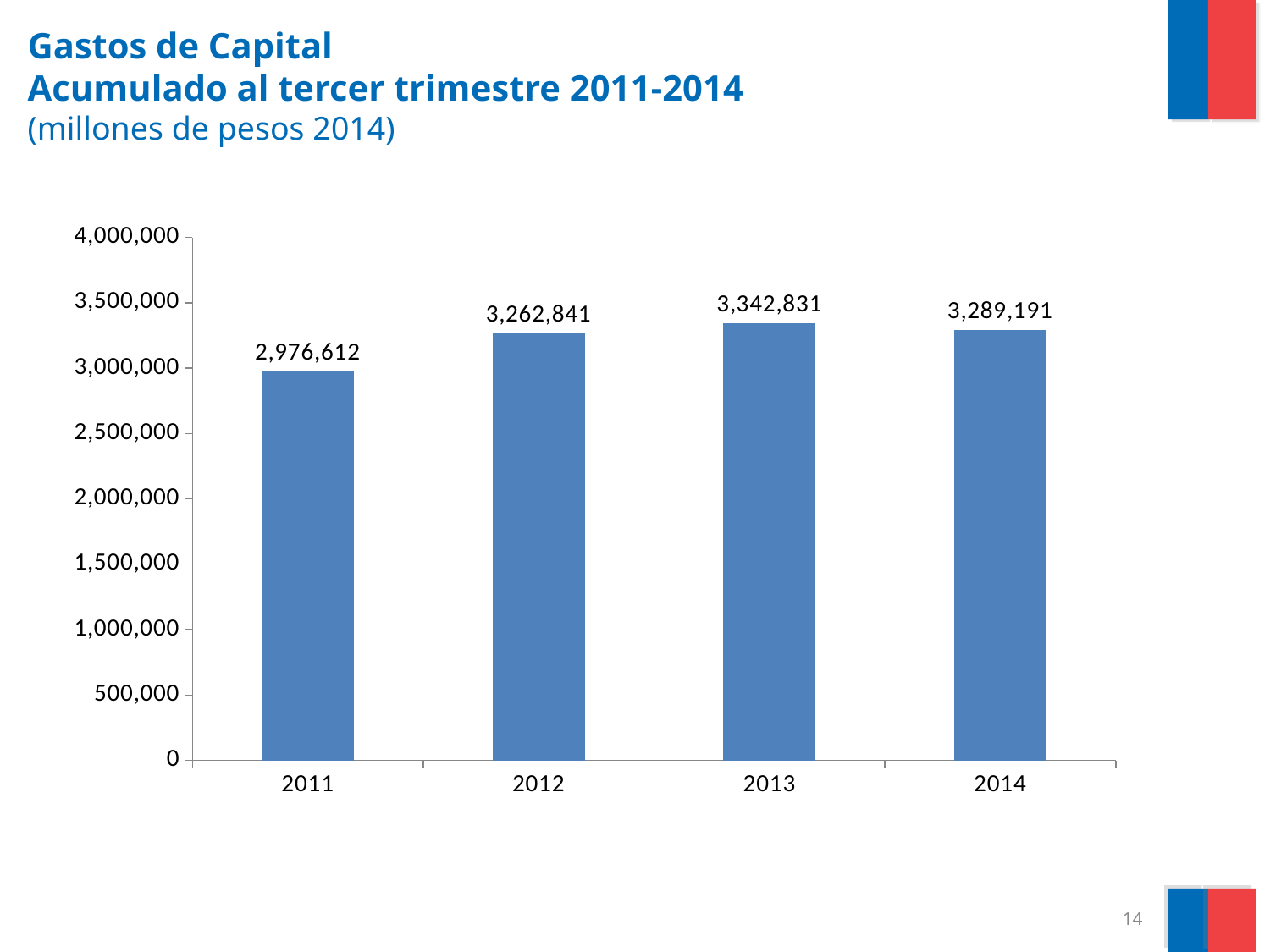
Which year has the highest value? 2013 How many years are shown on the x axis? 4 What is the difference between the values for 2013 and 2011? 366,219 Which is larger, the value for 2012 or the value for 2014? 2014 What is the difference between the values for 2013 and 2014? 53,640 What is the value for 2011? 2,976,612 Which year has the lowest value? 2011 What is the value for 2013? 3,342,831 Is the value for 2011 greater or less than 3,000,000? less What kind of chart is shown on the slide? bar chart What unit is stated in the chart's subtitle? millones de pesos 2014 What is the value for 2014? 3,289,191